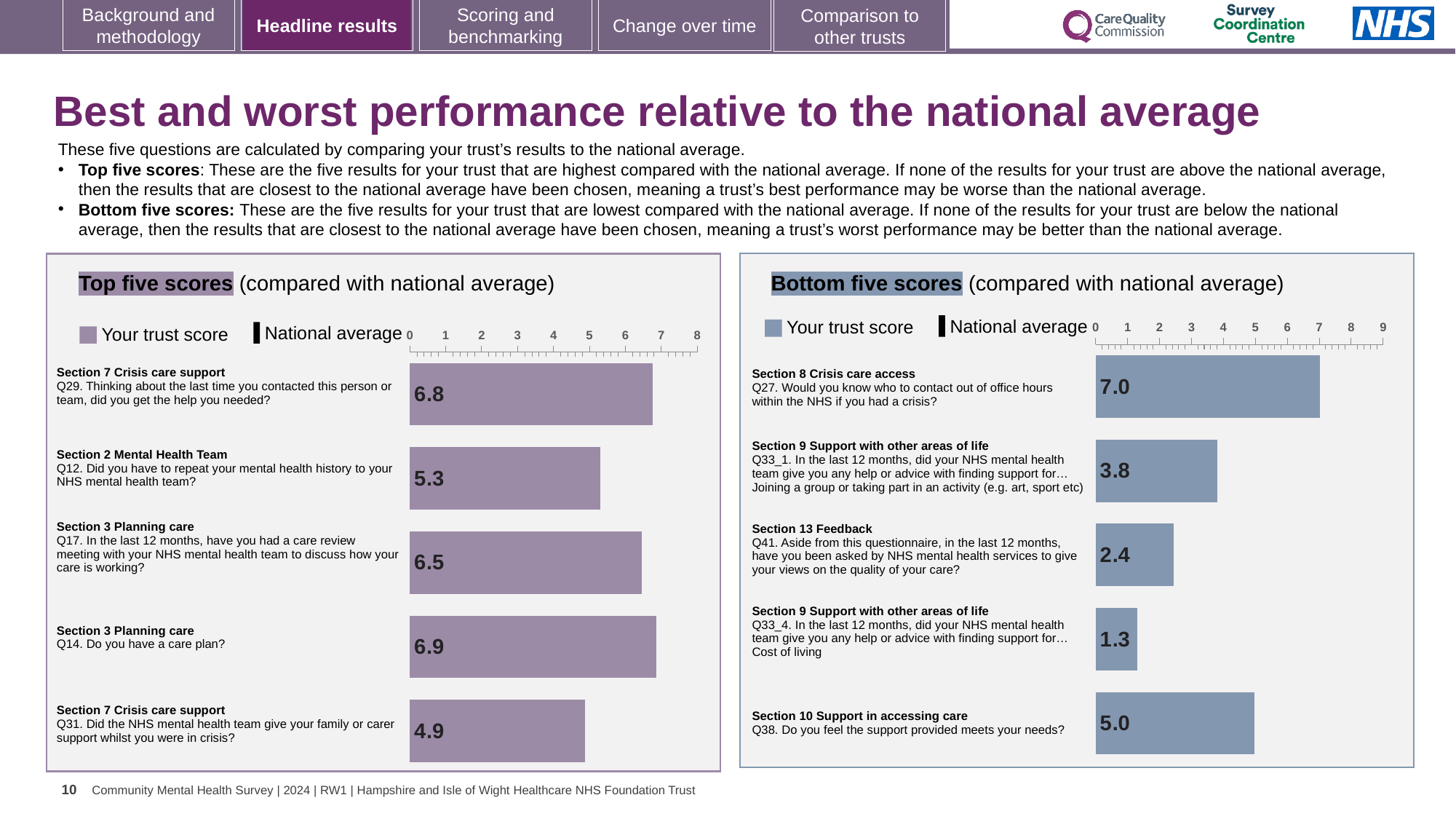
What type of chart is used for the Top five scores? Bar chart In the Top five scores chart, what is the trust score for Q31 (Did the NHS mental health team give your family or carer support whilst you were in crisis?)? 4.9 In the Top five scores chart, which has a higher trust score: Q17 or Q31? Q17 In the Top five scores chart, what is the trust score for Q14 (Do you have a care plan?)? 6.9 How many bars are shown in the Bottom five scores chart? 5 In the Top five scores chart, what is the difference between the trust scores for Q29 and Q12? 1.5 In the Bottom five scores chart, what is the trust score for Q27 (Would you know who to contact out of office hours within the NHS if you had a crisis?)? 7.0 In the Top five scores chart, which question has the highest trust score? Q14. Do you have a care plan? In the Bottom five scores chart, what is the trust score for Q33_4 (help or advice with finding support for cost of living)? 1.3 In the Bottom five scores chart, which question has the lowest trust score? Q33_4 (Cost of living) What is the maximum value shown on the x axis of the Bottom five scores chart? 9 In the Bottom five scores chart, what is the difference between the trust scores for Q27 and Q41? 4.6